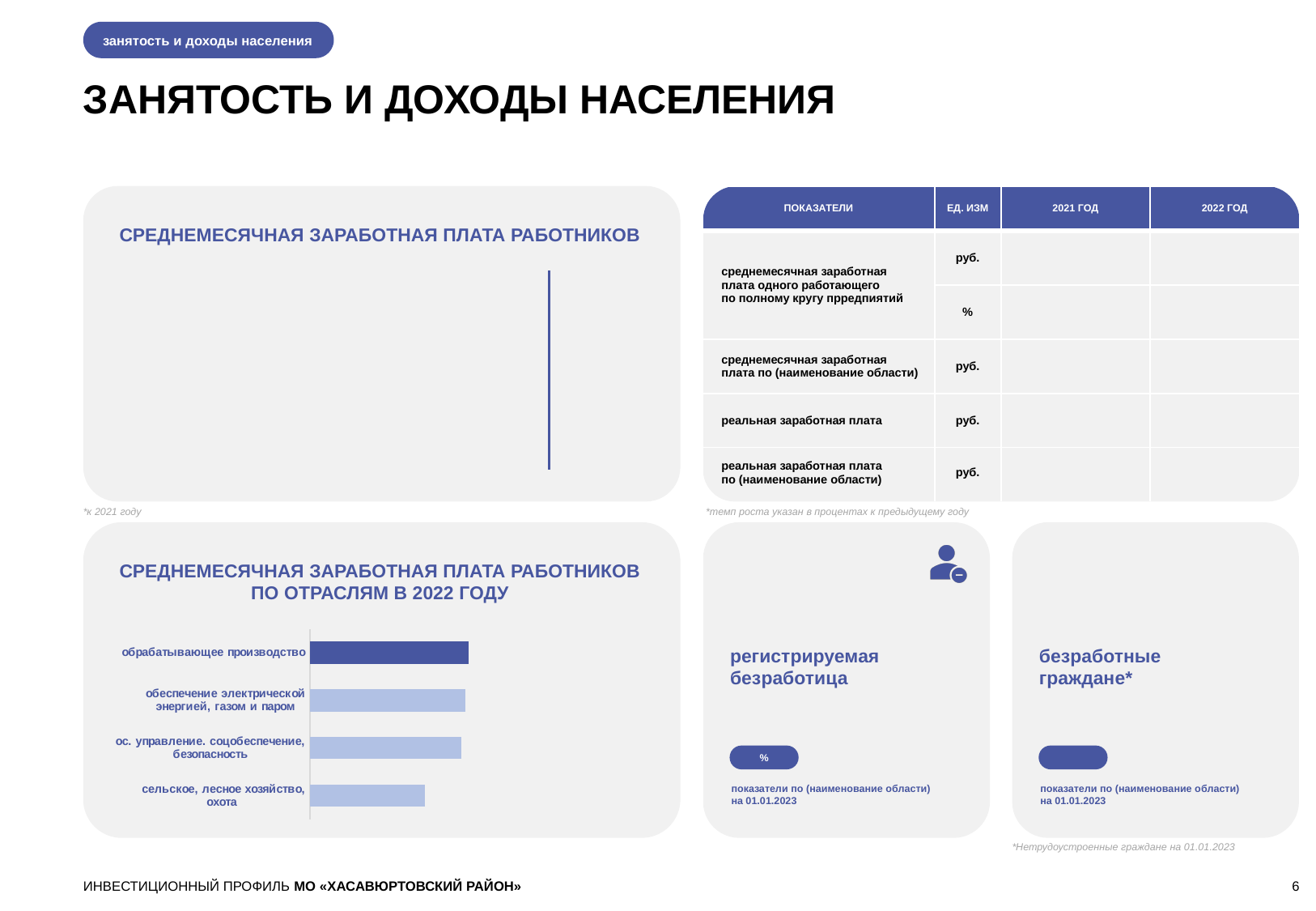
What kind of chart is "СРЕДНЕМЕСЯЧНАЯ ЗАРАБОТНАЯ ПЛАТА РАБОТНИКОВ ПО ОТРАСЛЯМ В 2022 ГОДУ"? bar chart In the chart "СРЕДНЕМЕСЯЧНАЯ ЗАРАБОТНАЯ ПЛАТА РАБОТНИКОВ ПО ОТРАСЛЯМ В 2022 ГОДУ", which is larger: ос. управление. соцобеспечение, безопасность or сельское, лесное хозяйство, охота? ос. управление. соцобеспечение, безопасность In the chart "СРЕДНЕМЕСЯЧНАЯ ЗАРАБОТНАЯ ПЛАТА РАБОТНИКОВ ПО ОТРАСЛЯМ В 2022 ГОДУ", which bar is drawn in a darker blue than the others? обрабатывающее производство How many categories are shown in the chart "СРЕДНЕМЕСЯЧНАЯ ЗАРАБОТНАЯ ПЛАТА РАБОТНИКОВ ПО ОТРАСЛЯМ В 2022 ГОДУ"? 4 In the chart "СРЕДНЕМЕСЯЧНАЯ ЗАРАБОТНАЯ ПЛАТА РАБОТНИКОВ ПО ОТРАСЛЯМ В 2022 ГОДУ", which category is the top bar? обрабатывающее производство In the chart "СРЕДНЕМЕСЯЧНАЯ ЗАРАБОТНАЯ ПЛАТА РАБОТНИКОВ ПО ОТРАСЛЯМ В 2022 ГОДУ", which is larger: обрабатывающее производство or сельское, лесное хозяйство, охота? обрабатывающее производство In the chart "СРЕДНЕМЕСЯЧНАЯ ЗАРАБОТНАЯ ПЛАТА РАБОТНИКОВ ПО ОТРАСЛЯМ В 2022 ГОДУ", which category has the lowest value? сельское, лесное хозяйство, охота In the chart "СРЕДНЕМЕСЯЧНАЯ ЗАРАБОТНАЯ ПЛАТА РАБОТНИКОВ ПО ОТРАСЛЯМ В 2022 ГОДУ", which category has the highest value? обрабатывающее производство In the chart "СРЕДНЕМЕСЯЧНАЯ ЗАРАБОТНАЯ ПЛАТА РАБОТНИКОВ ПО ОТРАСЛЯМ В 2022 ГОДУ", which is larger: обеспечение электрической энергией, газом и паром or сельское, лесное хозяйство, охота? обеспечение электрической энергией, газом и паром